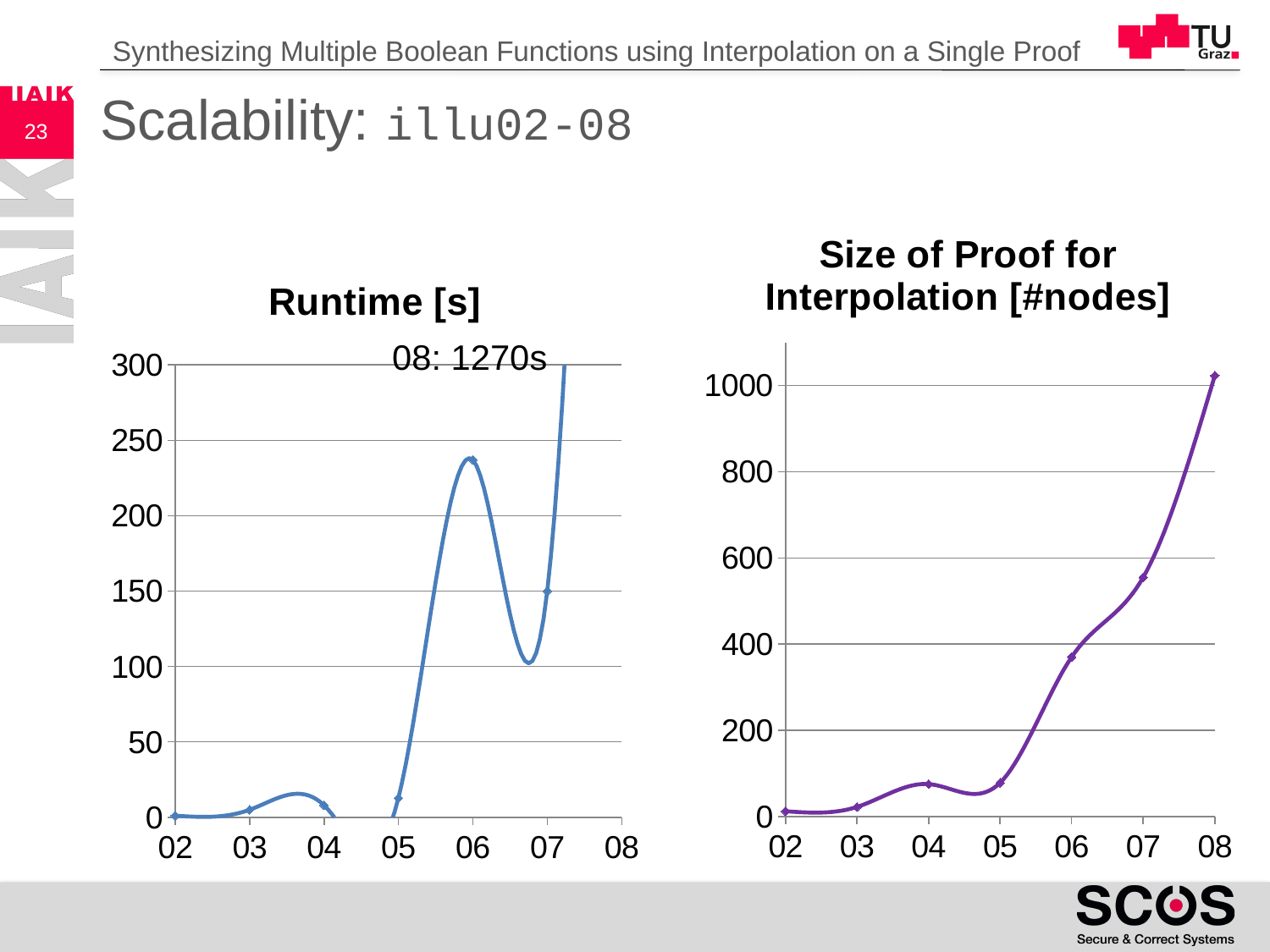
In the Size of Proof for Interpolation [#nodes] chart, is the value for 05 greater or less than 200? less What kind of chart is the Runtime [s] chart? line chart How many instances are shown on the x axis of the Runtime [s] chart? 7 In the Size of Proof for Interpolation [#nodes] chart, which is larger, the value for 06 or the value for 07? 07 In the Runtime [s] chart, what runtime is annotated for instance 08? 1270s In the Size of Proof for Interpolation [#nodes] chart, is the value for 07 greater or less than 400? greater What kind of chart is the Size of Proof for Interpolation [#nodes] chart? line chart In the Runtime [s] chart, is the value for 06 greater or less than 200? greater In the Size of Proof for Interpolation [#nodes] chart, which instance has the largest proof size? 08 How many instances are shown on the x axis of the Size of Proof for Interpolation [#nodes] chart? 7 In the Size of Proof for Interpolation [#nodes] chart, do the values generally rise or fall from 02 to 08? rise